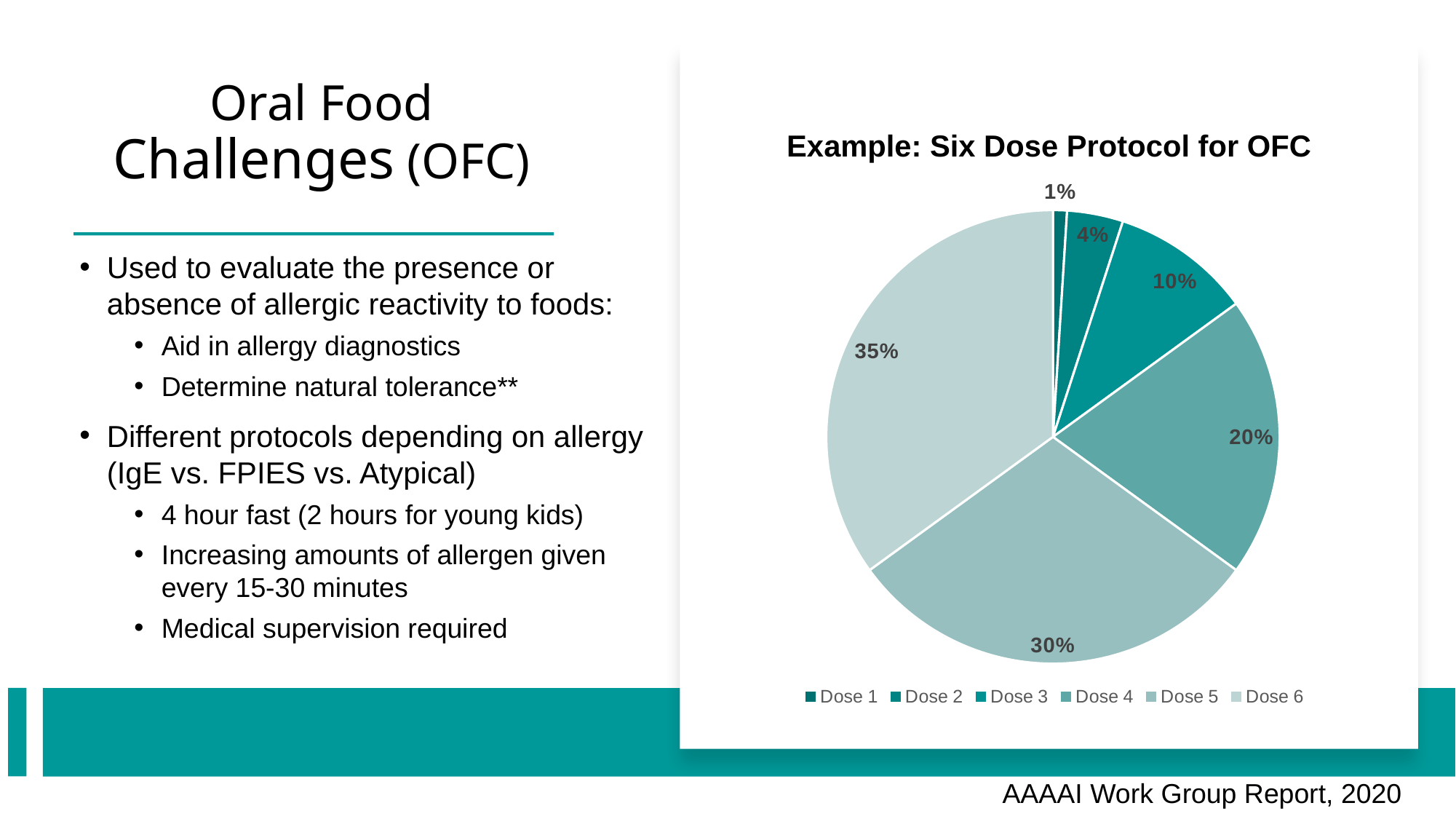
How many slices does the pie chart have? 6 What is the difference between the Dose 5 and Dose 4 percentages? 10% What type of chart is shown on the slide? Pie chart What share of the pie does Dose 6 represent? 35% Which is larger, the slice for Dose 2 or the slice for Dose 3? Dose 3 Which dose has the largest slice of the pie? Dose 6 Which dose has the smallest slice of the pie? Dose 1 What is the value shown for Dose 3? 10% What is the value shown for Dose 1? 1% What is the combined percentage of Dose 1, Dose 2 and Dose 3? 15% How many entries does the chart legend list? 6 What is the title of the chart? Example: Six Dose Protocol for OFC